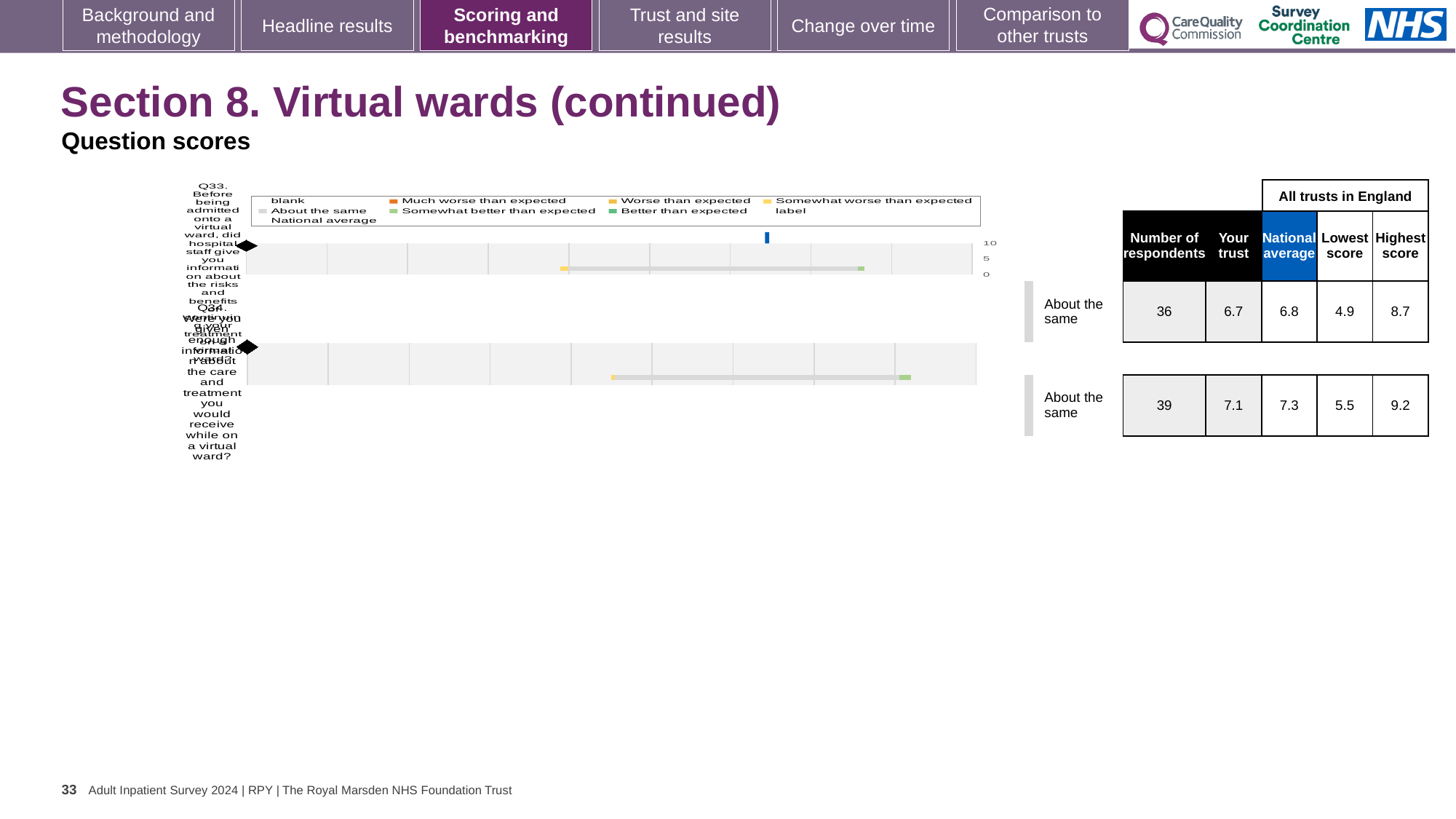
In the table beside the chart, what is the 'Your trust' score for Q34? 7.1 In the table beside the chart, what is the difference between the highest score and the lowest score for Q34? 3.7 How many questions (categories) are plotted in the chart? 2 What kind of chart is shown on the slide? bar chart In the table beside the chart, what is the number of respondents for Q33? 36 In the table beside the chart, what is the lowest score for Q33? 4.9 Which question numbers are plotted in the chart? Q33 and Q34 In the table beside the chart, what is the highest score for Q34? 9.2 In the table beside the chart, which question has the higher 'Your trust' score, Q33 or Q34? Q34 In the table beside the chart, how is the trust's result for Q33 categorised relative to other trusts? About the same In the table beside the chart, what is the national average for Q33? 6.8 What is the highest value shown on the chart's axis? 10